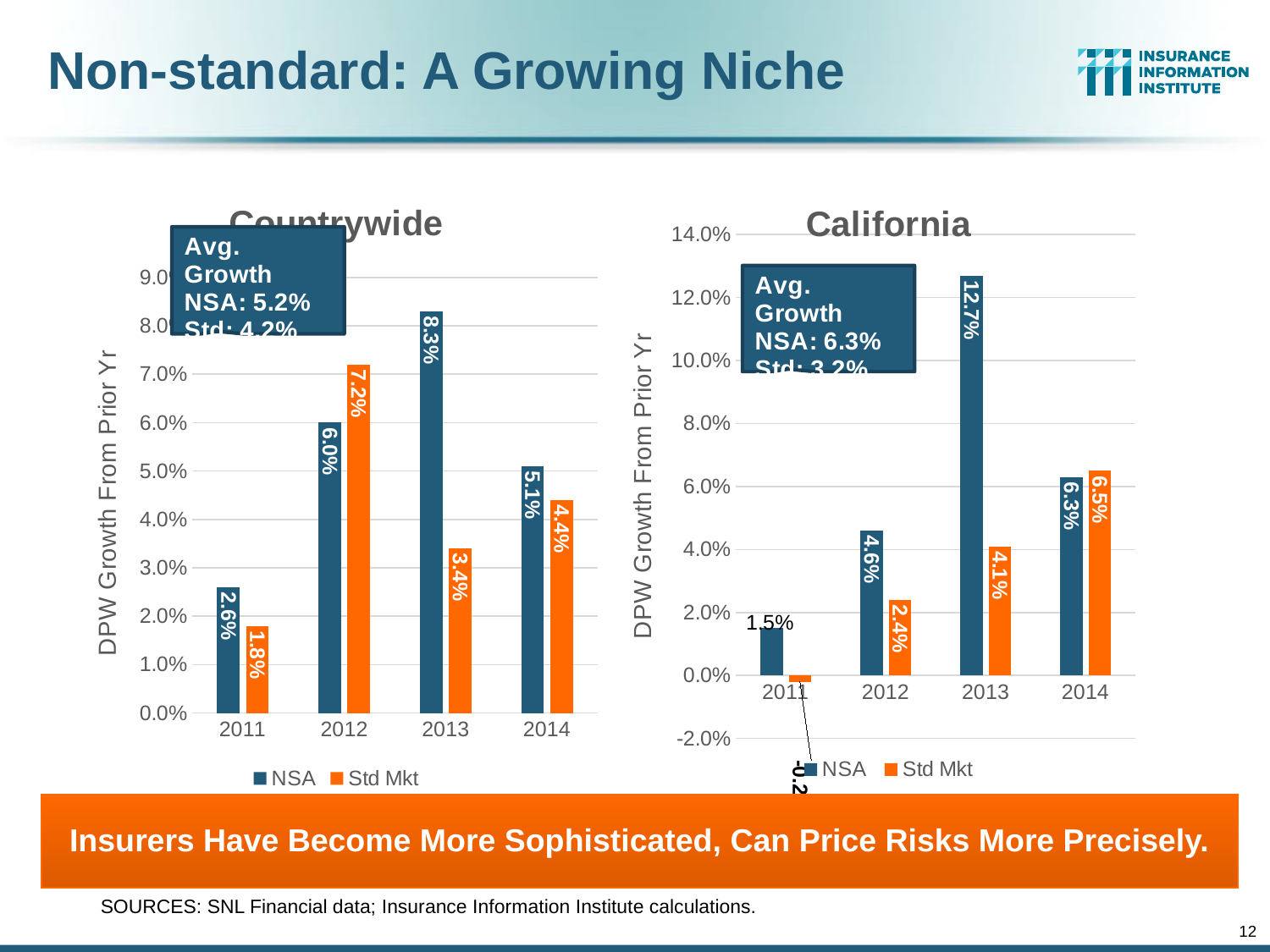
In the California chart, what is the Std Mkt value for 2014? 6.5% In the Countrywide chart, what is the Std Mkt value for 2012? 7.2% What kind of chart is the Countrywide chart? Bar chart In the Countrywide chart, which year has the highest NSA value? 2013 In the California chart, what is the NSA value for 2013? 12.7% How many years are shown on the x axis of the California chart? 4 In the Countrywide chart, which year has the lowest Std Mkt value? 2011 In the Countrywide chart, what is the NSA value for 2013? 8.3% In the Countrywide chart, which is larger for 2012, NSA or Std Mkt? Std Mkt In the California chart, is the NSA value for 2013 greater or less than 12.0%? greater How many series does the legend of the Countrywide chart list? 2 In the California chart, what is the difference between the NSA and Std Mkt values for 2013? 8.6%